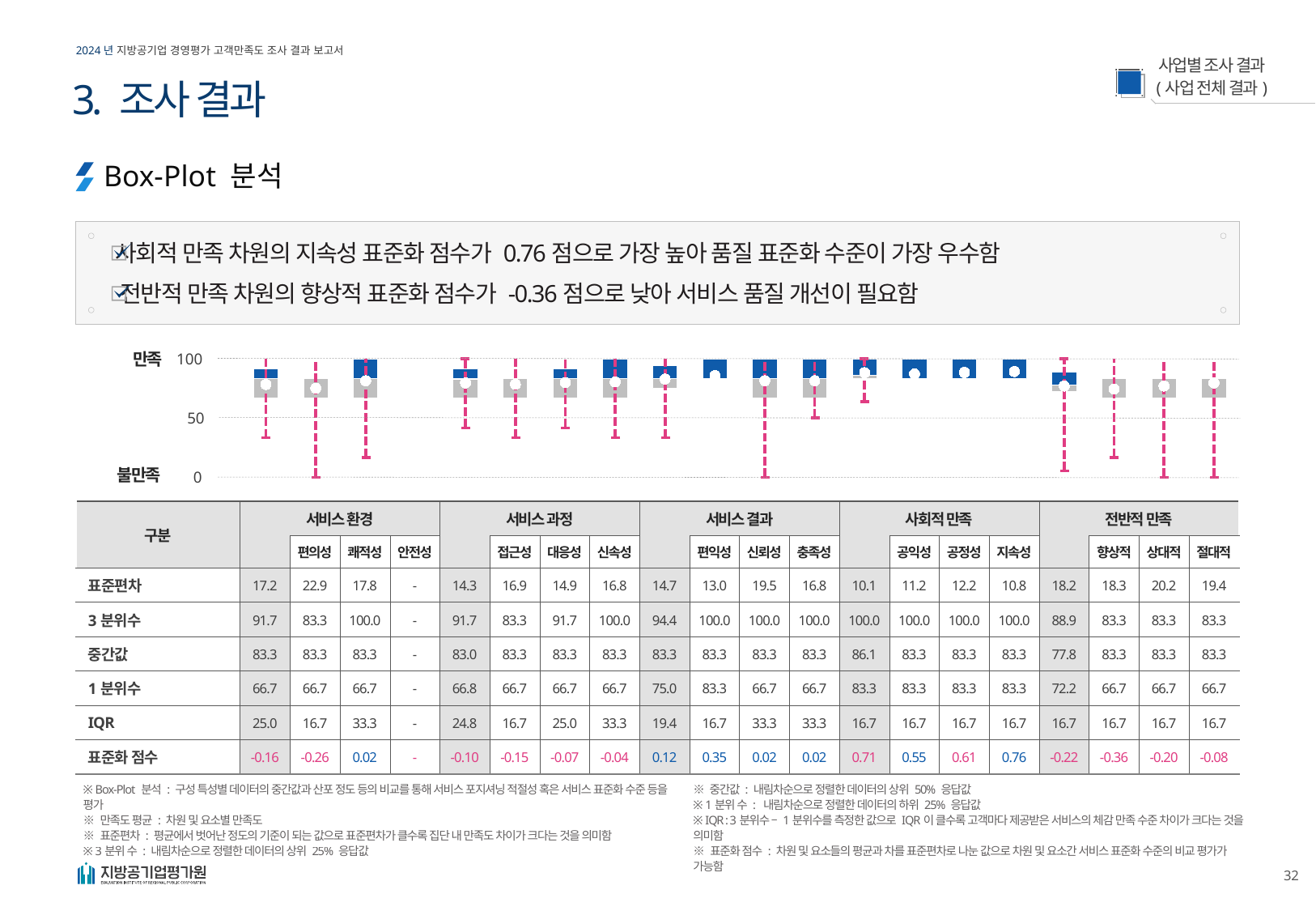
What is the highest tick value shown on the vertical axis of the box plot? 100 Is the 중간값 for the 전반적 만족 dimension overall greater or less than 50? greater What is the 표준화 점수 for 편익성 under 서비스 결과? 0.35 What kind of chart is shown on the slide? Box plot What is the 중간값 for the 사회적 만족 dimension overall? 86.1 Which item has the highest 표준화 점수 in the table below the box plot? 지속성 (0.76) What is the 1 분위수 for the 서비스 환경 dimension overall? 66.7 What is the difference between the 3 분위수 (94.4) and the 1 분위수 (75.0) for the 서비스 결과 dimension overall? 19.4 How many satisfaction dimensions (구분 groups) are shown in the table under the box plot? 5 Which has the larger 표준편차, 편의성 or 상대적? 편의성 What is the IQR for 쾌적성? 33.3 Which item has the lowest 표준화 점수 in the table below the box plot? 향상적 (-0.36)